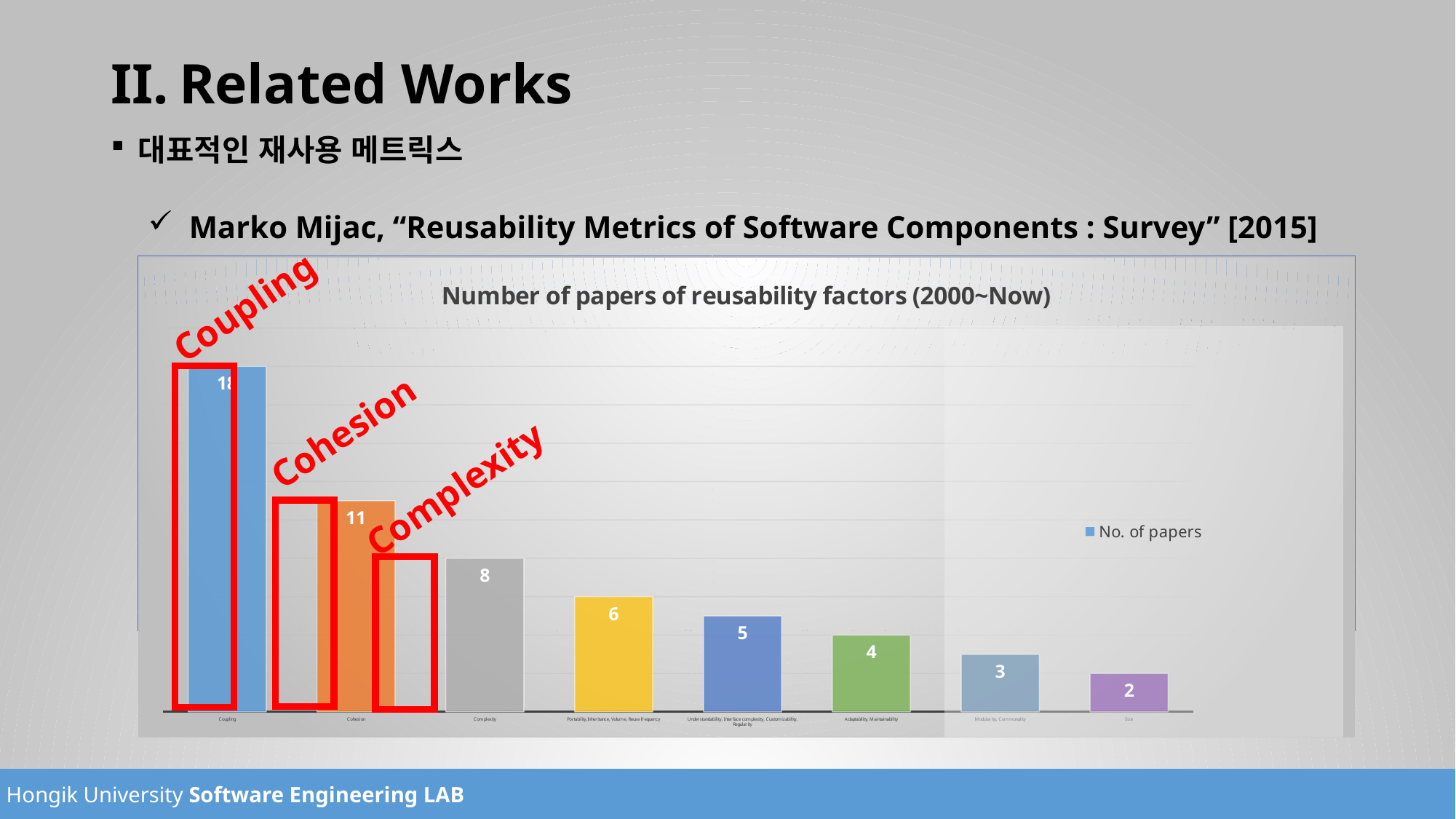
How many papers are shown for Complexity? 8 Which has more papers, Cohesion or Complexity? Cohesion Which reusability factor has the highest number of papers? Coupling What is the title of the chart? Number of papers of reusability factors (2000~Now) How many papers are shown for Coupling? 18 How many papers are shown for Size? 2 What is the difference in number of papers between Coupling and Cohesion? 7 What series name does the legend show? No. of papers What type of chart is shown on the slide? bar chart How many bars (categories) are shown in the chart? 8 How many papers are shown for Cohesion? 11 Which reusability factor has the lowest number of papers? Size